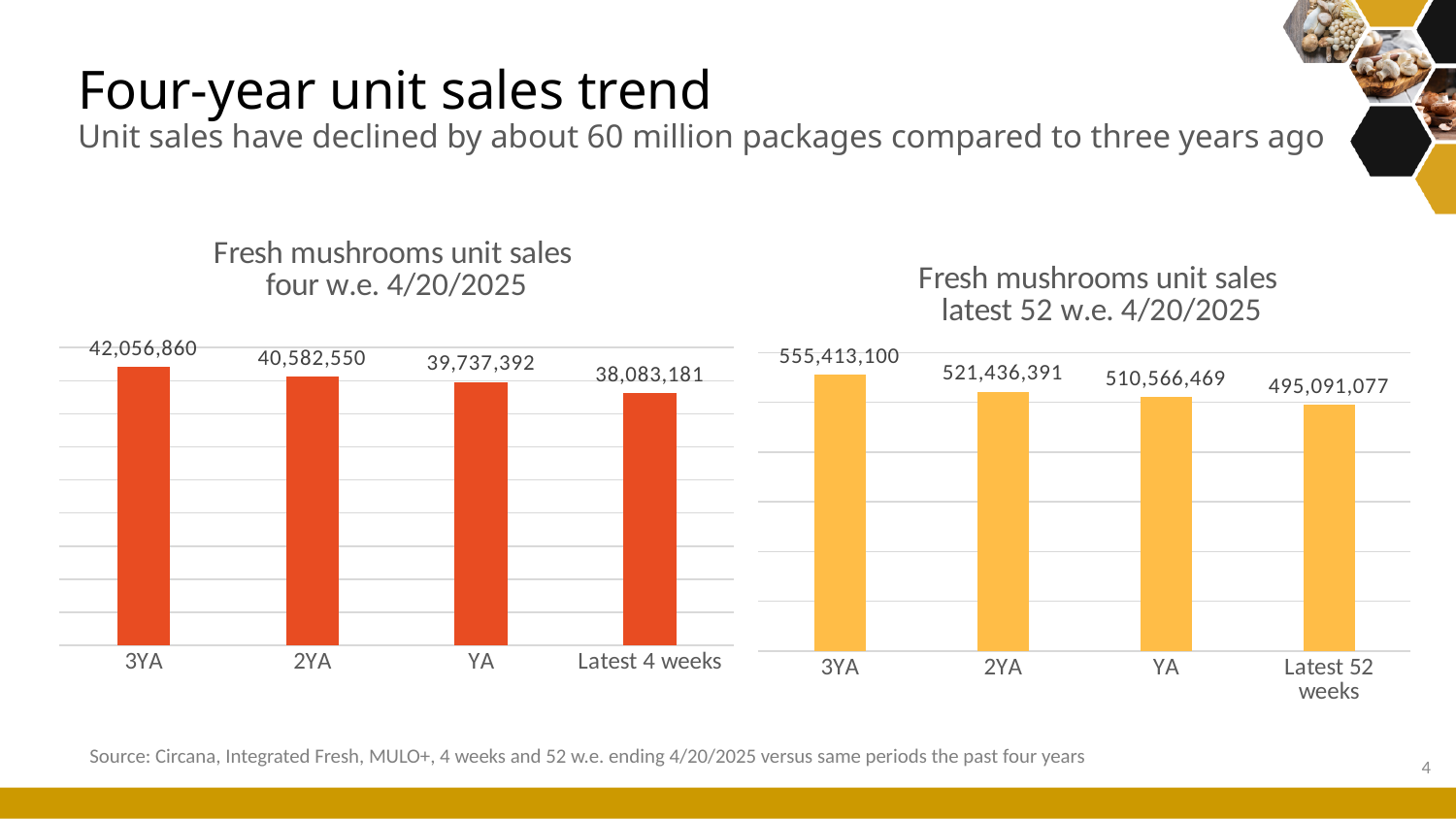
In the 'Fresh mushrooms unit sales four w.e. 4/20/2025' chart, which period has the highest value? 3YA What type of chart is the 'Fresh mushrooms unit sales latest 52 w.e. 4/20/2025' chart? Bar chart In the 'Fresh mushrooms unit sales four w.e. 4/20/2025' chart, what is the difference between the 3YA value and the Latest 4 weeks value? 3,973,679 In the 'Fresh mushrooms unit sales latest 52 w.e. 4/20/2025' chart, which period has the lowest value? Latest 52 weeks How many bars are shown in the 'Fresh mushrooms unit sales four w.e. 4/20/2025' chart? 4 In the 'Fresh mushrooms unit sales four w.e. 4/20/2025' chart, what is the value for Latest 4 weeks? 38,083,181 In the 'Fresh mushrooms unit sales four w.e. 4/20/2025' chart, what is the value for 3YA? 42,056,860 In the 'Fresh mushrooms unit sales four w.e. 4/20/2025' chart, do the values rise or fall from 3YA to Latest 4 weeks? Fall In the 'Fresh mushrooms unit sales latest 52 w.e. 4/20/2025' chart, what is the value for 2YA? 521,436,391 In the 'Fresh mushrooms unit sales latest 52 w.e. 4/20/2025' chart, which is larger, the value for 2YA or the value for YA? 2YA In the 'Fresh mushrooms unit sales latest 52 w.e. 4/20/2025' chart, what is the value for Latest 52 weeks? 495,091,077 In the 'Fresh mushrooms unit sales latest 52 w.e. 4/20/2025' chart, what is the difference between the 3YA value and the Latest 52 weeks value? 60,322,023